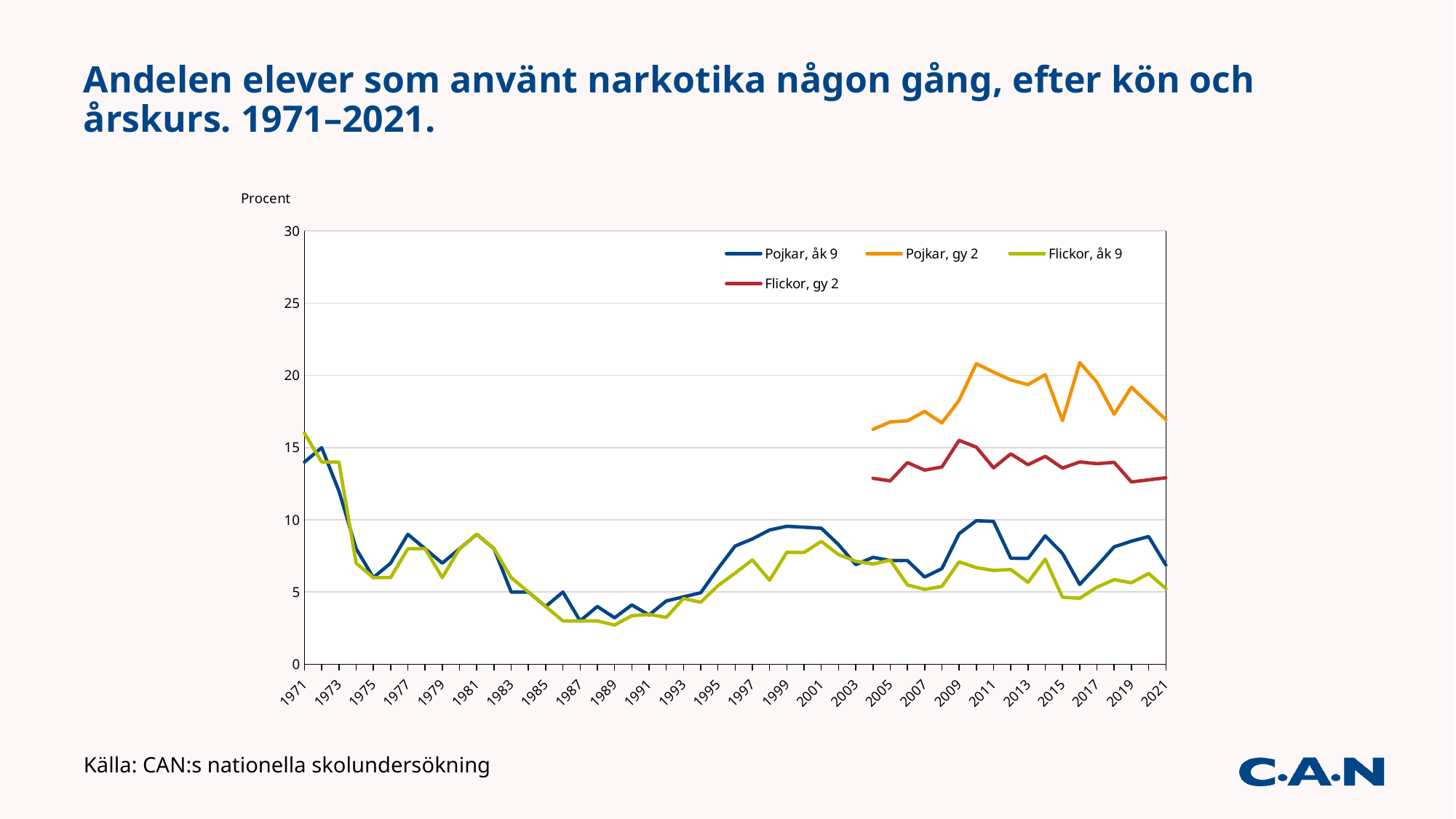
Which series has the highest value in 2021? Pojkar, gy 2 Is the value for Flickor, gy 2 in 2021 greater or less than 15? less How many series does the legend list? 4 What are the four series named in the legend? Pojkar, åk 9; Pojkar, gy 2; Flickor, åk 9; Flickor, gy 2 Is the value for Pojkar, gy 2 in 2021 greater or less than 15? greater What kind of chart is shown on the slide? line chart In 2011, which is larger: the value for Pojkar, gy 2 or the value for Flickor, gy 2? Pojkar, gy 2 Is the value for Flickor, åk 9 in 1987 greater or less than 5? less Does the value for Pojkar, åk 9 rise or fall between 1971 and 1975? fall Which series has the lowest value in 2021? Flickor, åk 9 What is the label on the vertical axis? Procent